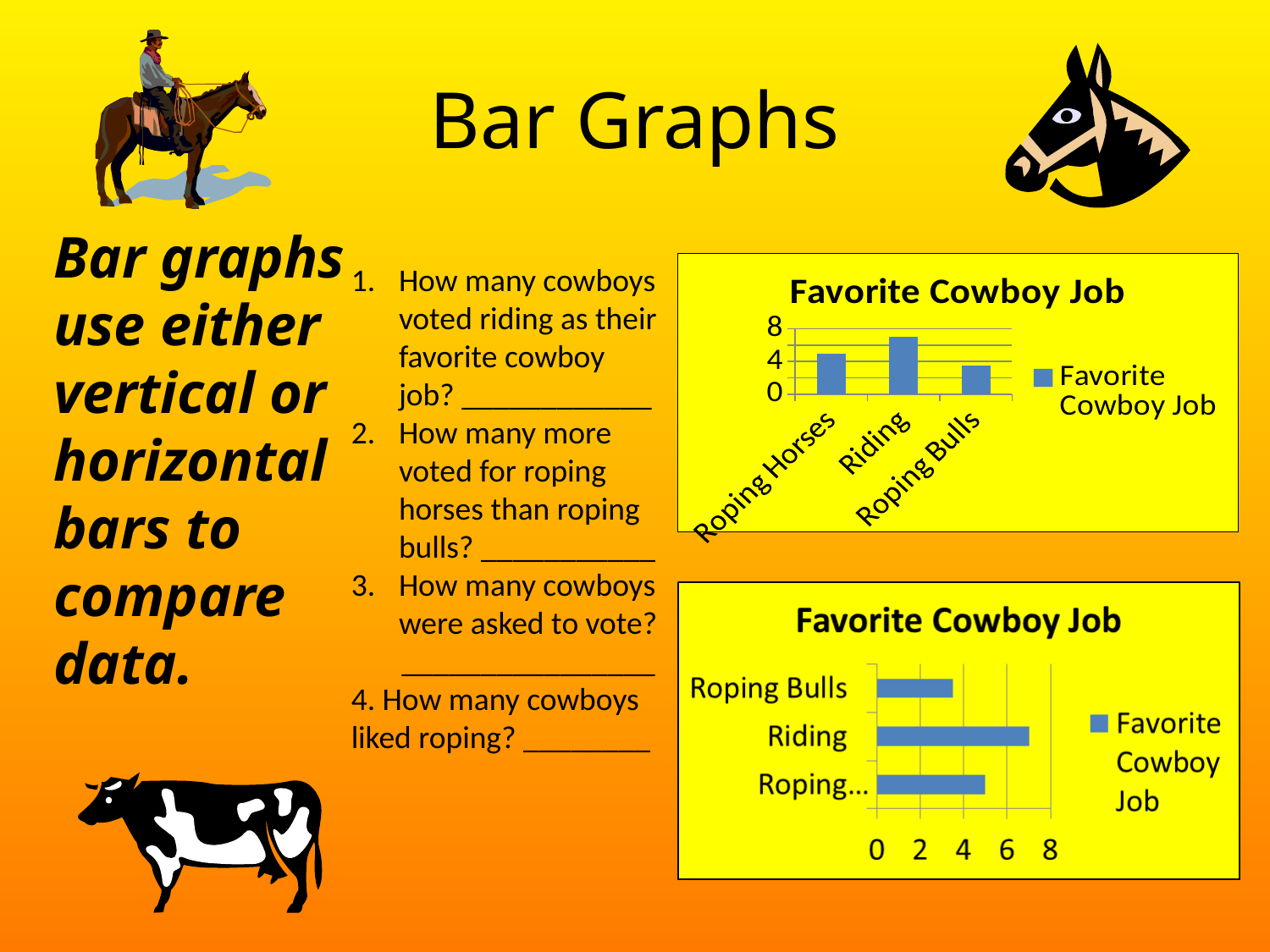
What kind of chart is the top chart on the slide? bar chart In the top chart, which category has the lowest value? Roping Bulls In the top chart, which category has the highest value? Riding In the bottom chart, which category has the longest bar? Riding In the top chart, how many categories are shown on the x axis? 3 How many series does the legend of the bottom chart list? 1 In the bottom chart, is the value for Riding greater or less than 8? less In the top chart, which is larger, the value for Roping Horses or the value for Roping Bulls? Roping Horses In the bottom chart, is the value for Roping Bulls greater or less than 4? less What is the title of the bottom chart? Favorite Cowboy Job In the top chart, is the value for Riding greater or less than 4? greater